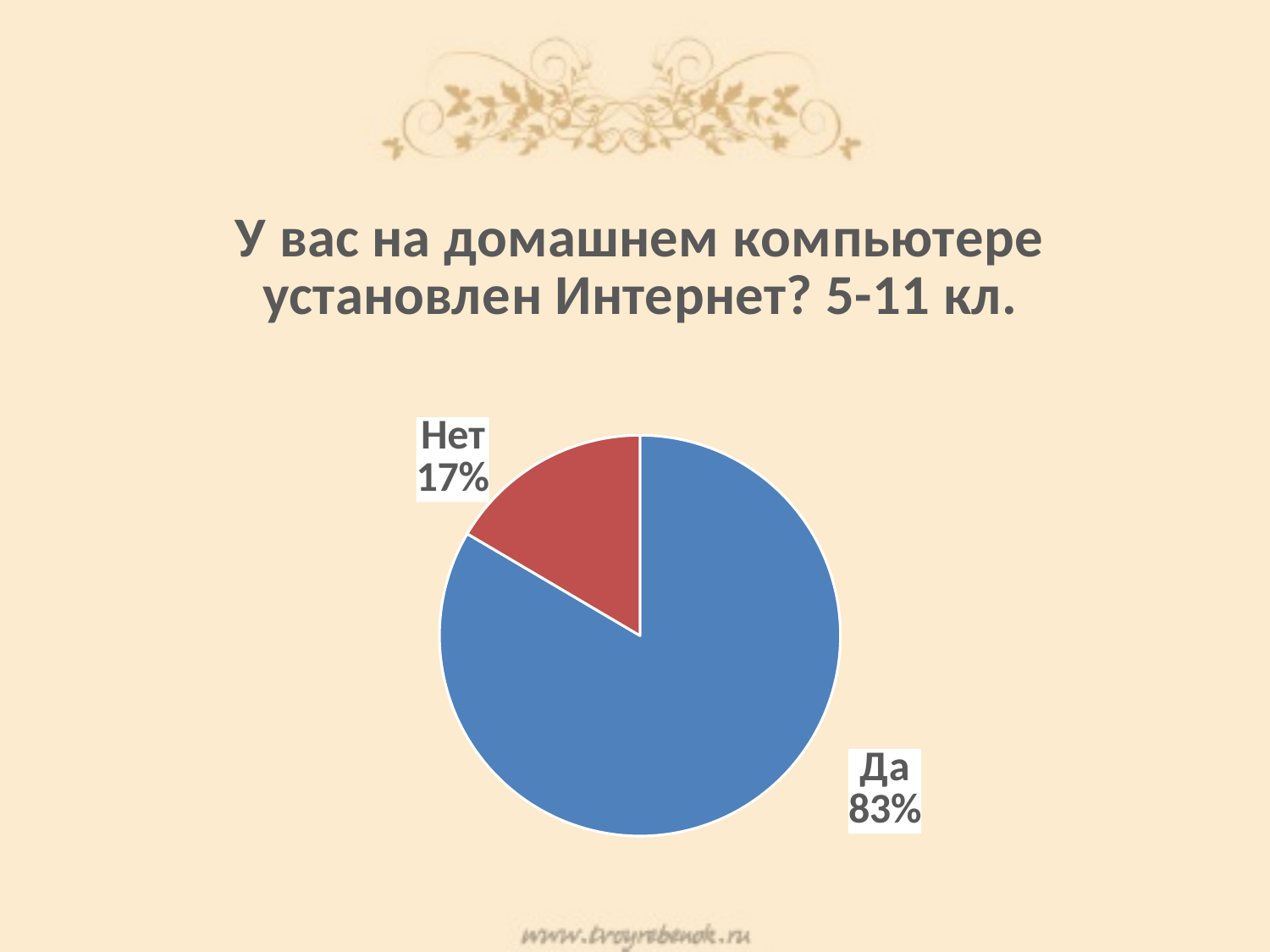
What is the difference in percentage points between the "Да" and "Нет" slices? 66 What colour is the "Нет" slice of the pie? red Which slice of the pie is the largest? Да What is the title of the chart on the slide? У вас на домашнем компьютере установлен Интернет? 5-11 кл. Which is larger, the "Да" slice or the "Нет" slice? Да What share of the pie does the "Да" slice represent? 83% What share of the pie does the "Нет" slice represent? 17% Which slice of the pie is the smallest? Нет What kind of chart is shown on the slide? pie chart How many slices does the pie chart have? 2